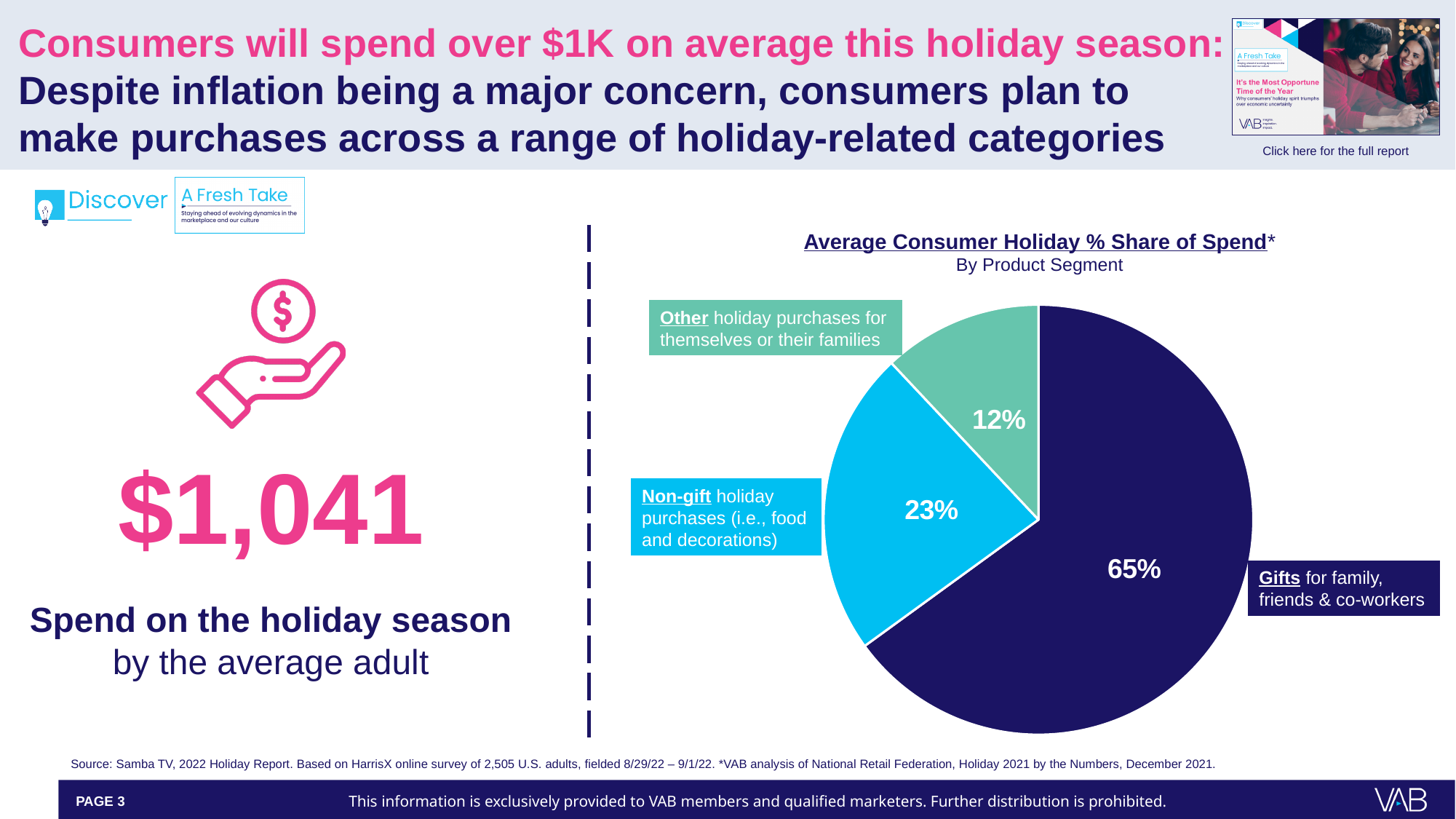
How many segments does the pie chart show? 3 What share of spend goes to Non-gift holiday purchases? 23% What share of spend goes to Gifts for family, friends & co-workers? 65% What share of spend goes to Other holiday purchases for themselves or their families? 12% What colour is the Gifts slice of the pie chart? Dark navy blue What is the title of the chart? Average Consumer Holiday % Share of Spend Which segment has the smallest share of spend? Other holiday purchases for themselves or their families What is the difference in share between Gifts and Non-gift holiday purchases? 42 percentage points Which is larger, the share for Non-gift holiday purchases or the share for Other holiday purchases? Non-gift holiday purchases What kind of chart is shown on the slide? Pie chart Which segment has the largest share of spend? Gifts for family, friends & co-workers What is the combined share of Non-gift and Other holiday purchases? 35%